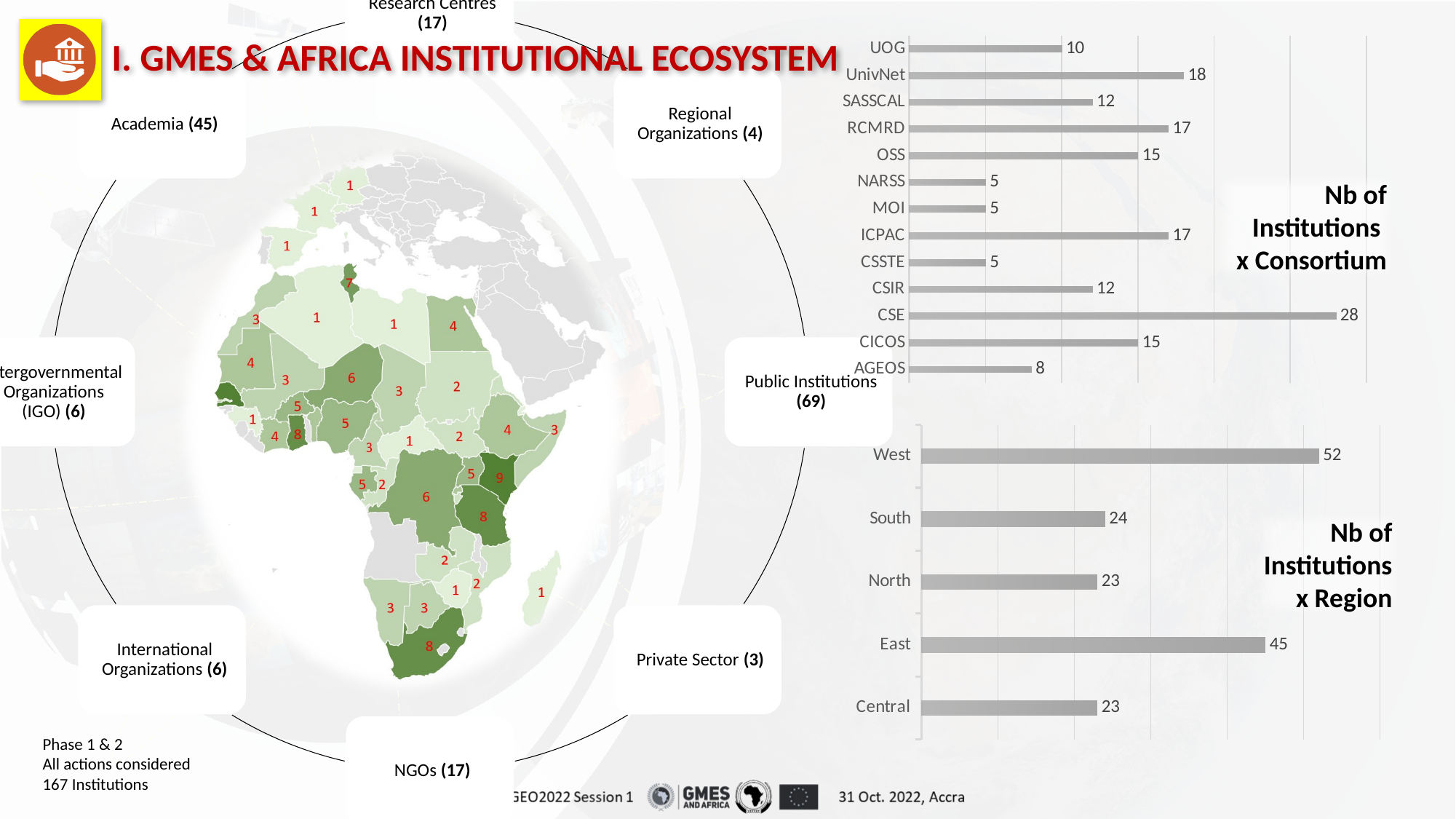
How many consortia are listed in the 'Nb of Institutions x Consortium' chart? 13 In the 'Nb of Institutions x Consortium' chart, what is the value for UnivNet? 18 In the 'Nb of Institutions x Region' chart, what is the value for West? 52 In the 'Nb of Institutions x Region' chart, what is the difference between West and South? 28 In the 'Nb of Institutions x Consortium' chart, which consortium has the highest number of institutions? CSE What type of chart is the 'Nb of Institutions x Region' chart? Bar chart In the 'Nb of Institutions x Region' chart, what is the value for East? 45 How many regions are shown in the 'Nb of Institutions x Region' chart? 5 In the 'Nb of Institutions x Consortium' chart, which is larger, RCMRD or OSS? RCMRD In the 'Nb of Institutions x Consortium' chart, what is the value for CSE? 28 In the 'Nb of Institutions x Consortium' chart, what is the difference between CSE and AGEOS? 20 In the 'Nb of Institutions x Region' chart, which region has the highest number of institutions? West